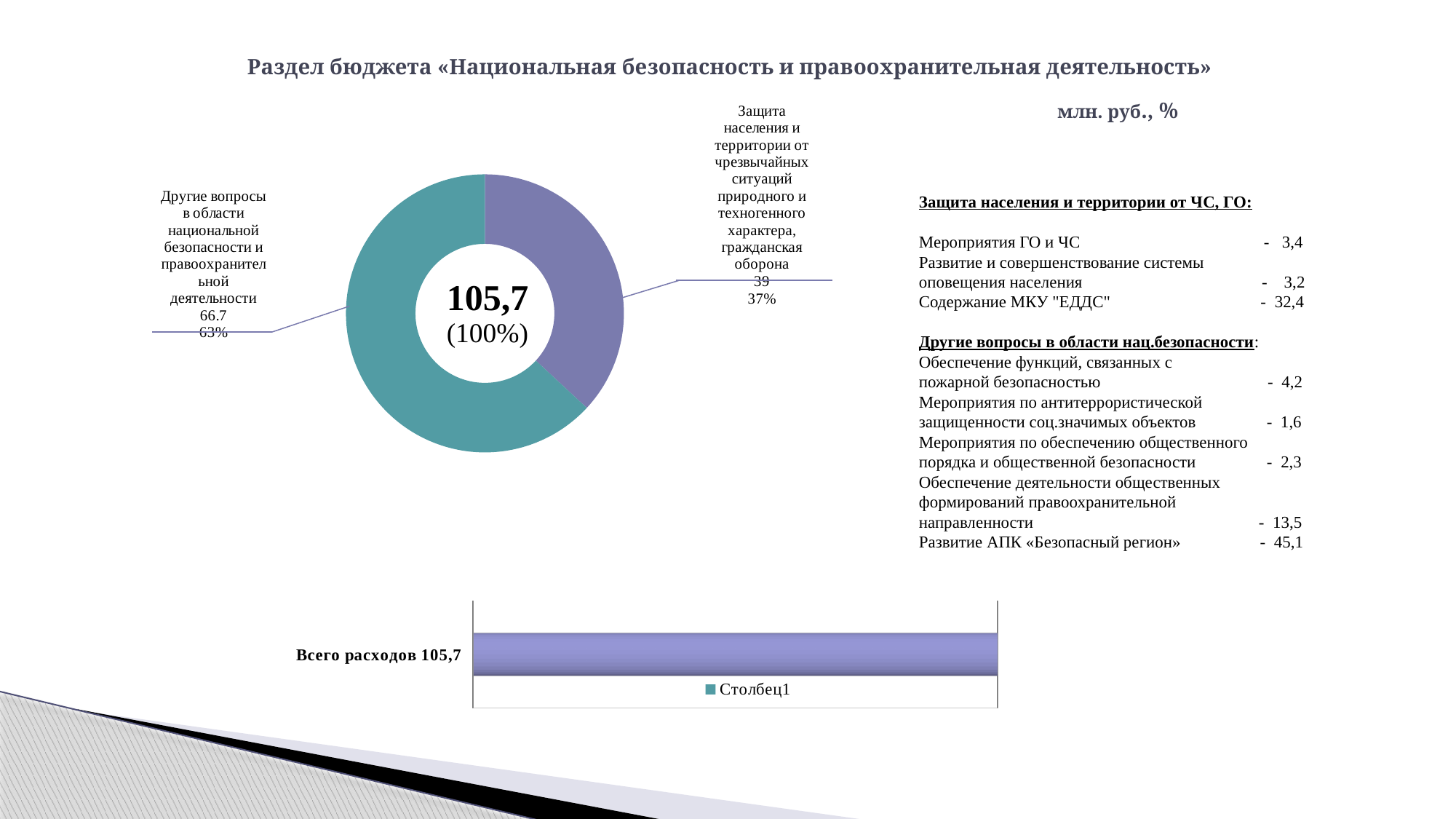
In the donut chart, what is the difference between the two slice values (66.7 and 39)? 27.7 In the donut chart, which category has the largest slice? Другие вопросы в области национальной безопасности и правоохранительной деятельности How many slices does the donut chart have? 2 In the donut chart, what share does «Другие вопросы в области национальной безопасности и правоохранительной деятельности» take? 63% What type of chart is shown at the bottom of the slide? Bar chart In the donut chart, what share does «Защита населения и территории от чрезвычайных ситуаций...» take? 37% In the donut chart, which category has the smallest slice? Защита населения и территории от чрезвычайных ситуаций природного и техногенного характера, гражданская оборона In the donut chart, what is the value for «Другие вопросы в области национальной безопасности и правоохранительной деятельности»? 66.7 What type of chart is shown in the upper left of the slide? Donut (pie) chart In the bar chart at the bottom of the slide, what series name does the legend list? Столбец1 In the donut chart, what is the value for «Защита населения и территории от чрезвычайных ситуаций природного и техногенного характера, гражданская оборона»? 39 What total value is shown in the centre of the donut chart? 105,7 (100%)